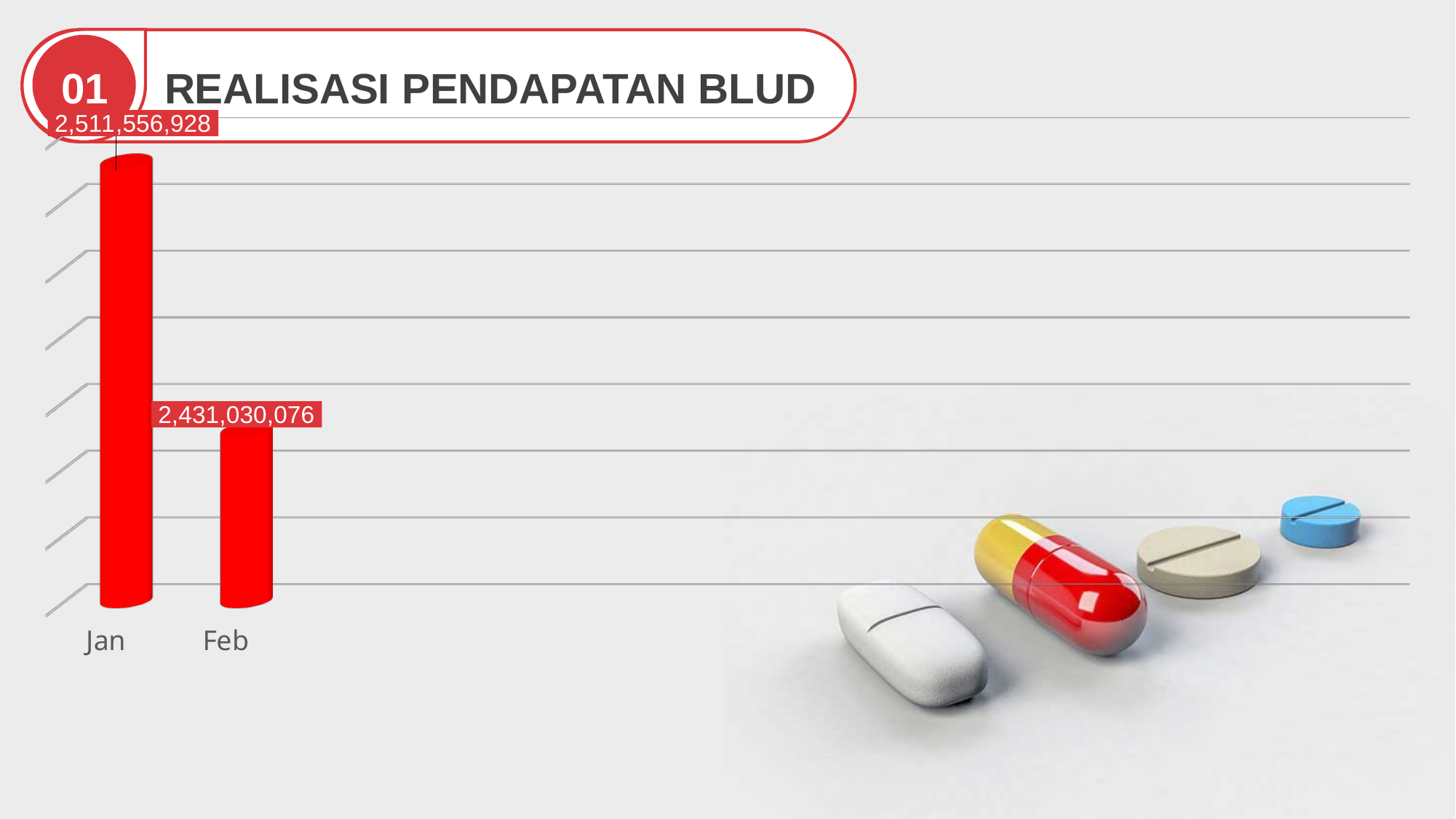
Which month has the lowest value? Feb Do the values rise or fall from Jan to Feb? Fall Which month has the highest value? Jan What is the title of the slide containing the chart? REALISASI PENDAPATAN BLUD Which is larger, the value for Jan or the value for Feb? Jan What is the value for Feb? 2,431,030,076 How many categories are shown on the x axis? 2 What is the value for Jan? 2,511,556,928 What colour are the bars in the chart? Red What kind of chart is shown on the slide? Bar chart What is the difference between the values for Jan and Feb? 80,526,852